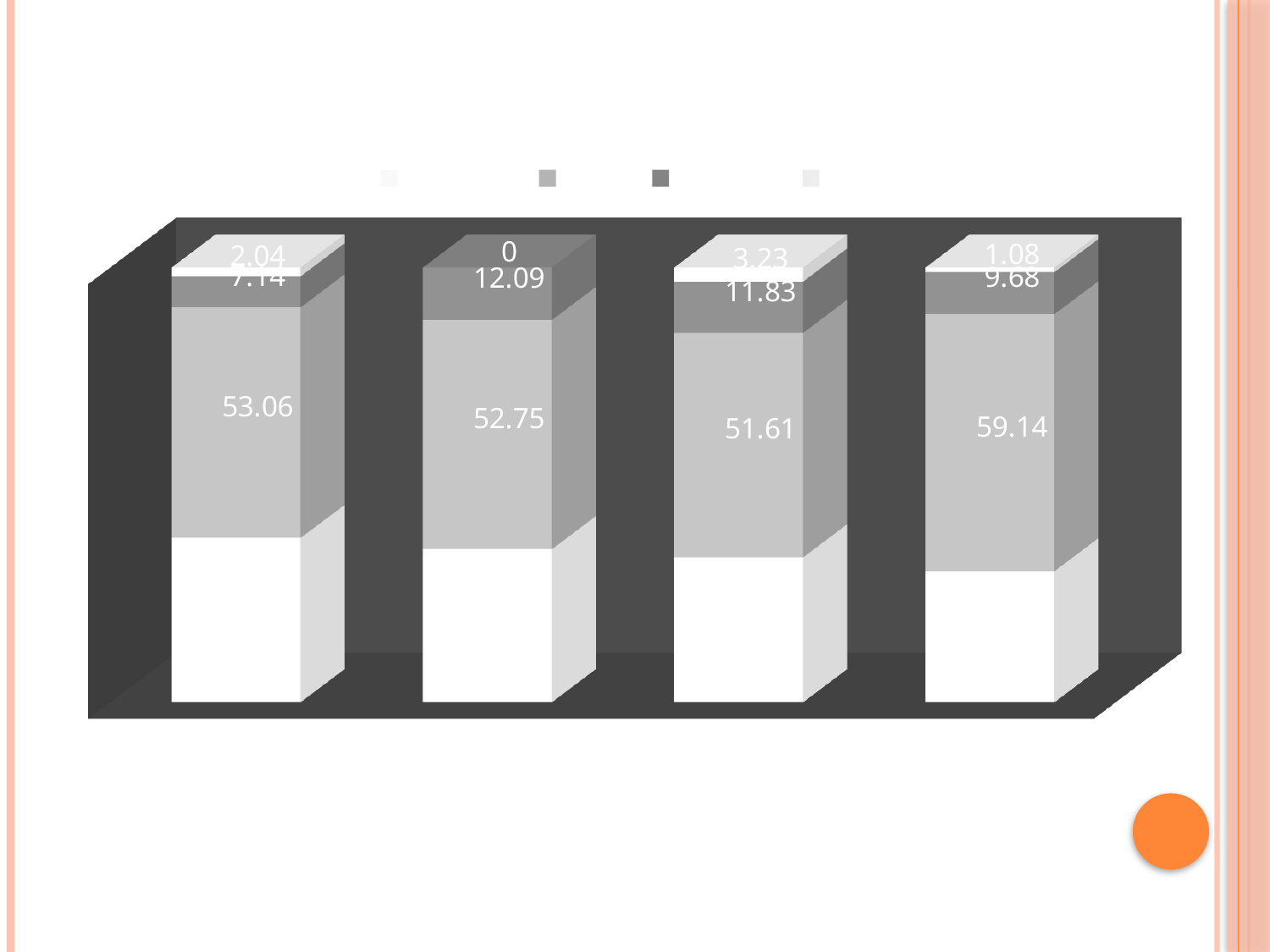
What kind of chart is shown on the slide? stacked bar chart Which bar has the highest value for the large light grey segment? the fourth (rightmost) bar What is the value of the dark grey segment in the third bar? 11.83 What is the value of the large light grey segment in the first (leftmost) bar? 53.06 How many series does the legend list? 4 What is the value of the large light grey segment in the fourth (rightmost) bar? 59.14 Which bar has the lowest value for the large light grey segment? the third bar How many bars does the chart contain? 4 Which is larger: the topmost segment of the third bar or the topmost segment of the fourth bar? the third bar (3.23) What is the difference between the light grey segment values of the fourth bar (59.14) and the third bar (51.61)? 7.53 What is the difference between the dark grey segment values of the second bar (12.09) and the first bar (7.14)? 4.95 What is the value of the topmost segment in the second bar? 0